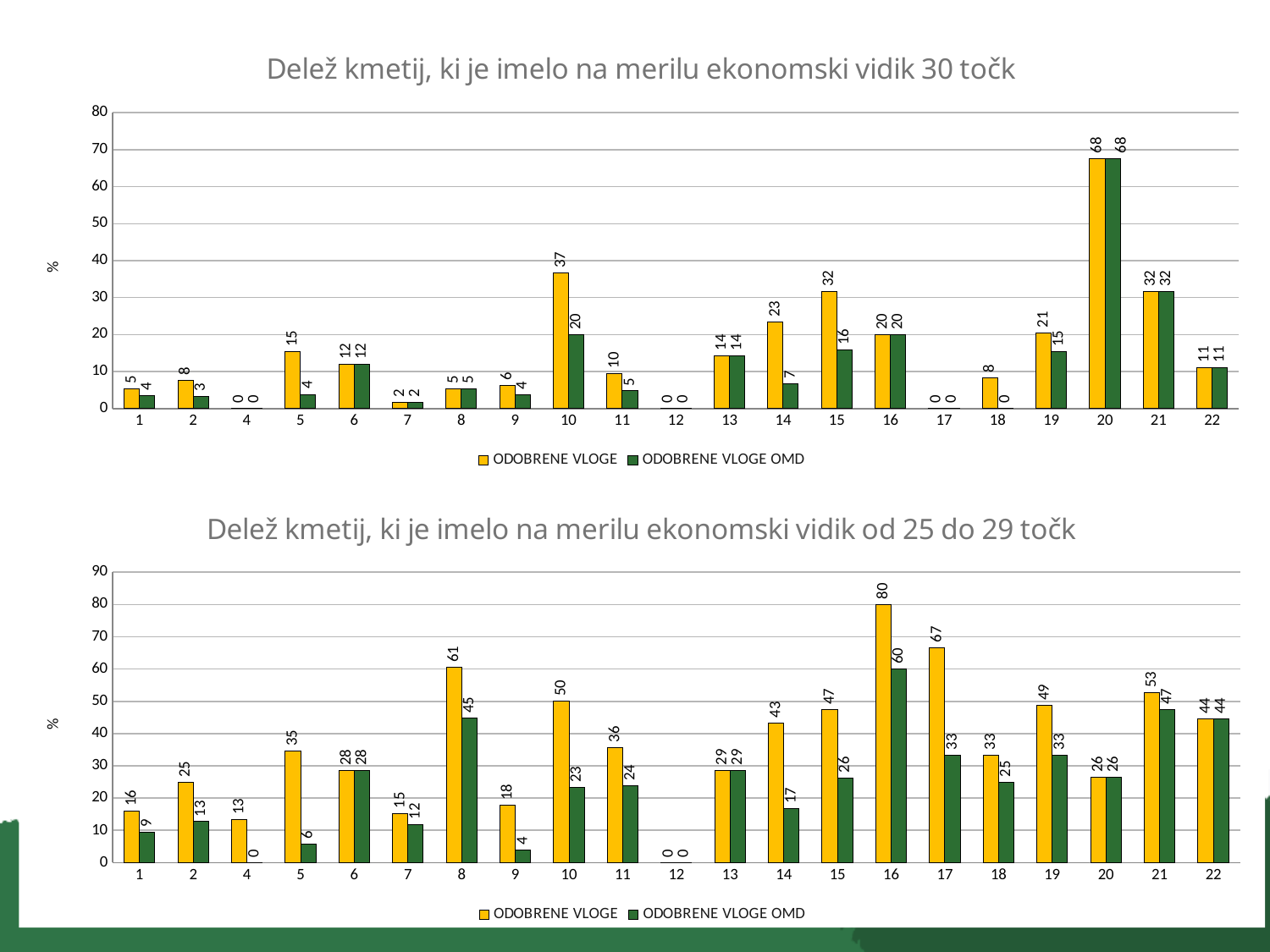
In the top chart (30 točk), what is the value of ODOBRENE VLOGE OMD for category 15? 16 In the top chart (30 točk), what is the value of ODOBRENE VLOGE for category 10? 37 In the top chart (30 točk), what is the difference between ODOBRENE VLOGE and ODOBRENE VLOGE OMD for category 14? 16 In the bottom chart (od 25 do 29 točk), what is the value of ODOBRENE VLOGE OMD for category 8? 45 In the top chart (30 točk), which category has the highest ODOBRENE VLOGE value? 20 How many categories are shown on the x axis of the bottom chart (od 25 do 29 točk)? 21 What type of chart is the top chart (30 točk)? Bar chart In the bottom chart (od 25 do 29 točk), which is larger for category 17: ODOBRENE VLOGE or ODOBRENE VLOGE OMD? ODOBRENE VLOGE In the bottom chart (od 25 do 29 točk), what is the value of ODOBRENE VLOGE for category 16? 80 In the top chart (30 točk), how many series does the legend list? 2 In the bottom chart (od 25 do 29 točk), what is the difference between ODOBRENE VLOGE and ODOBRENE VLOGE OMD for category 10? 27 In the bottom chart (od 25 do 29 točk), which category has the highest ODOBRENE VLOGE OMD value? 16